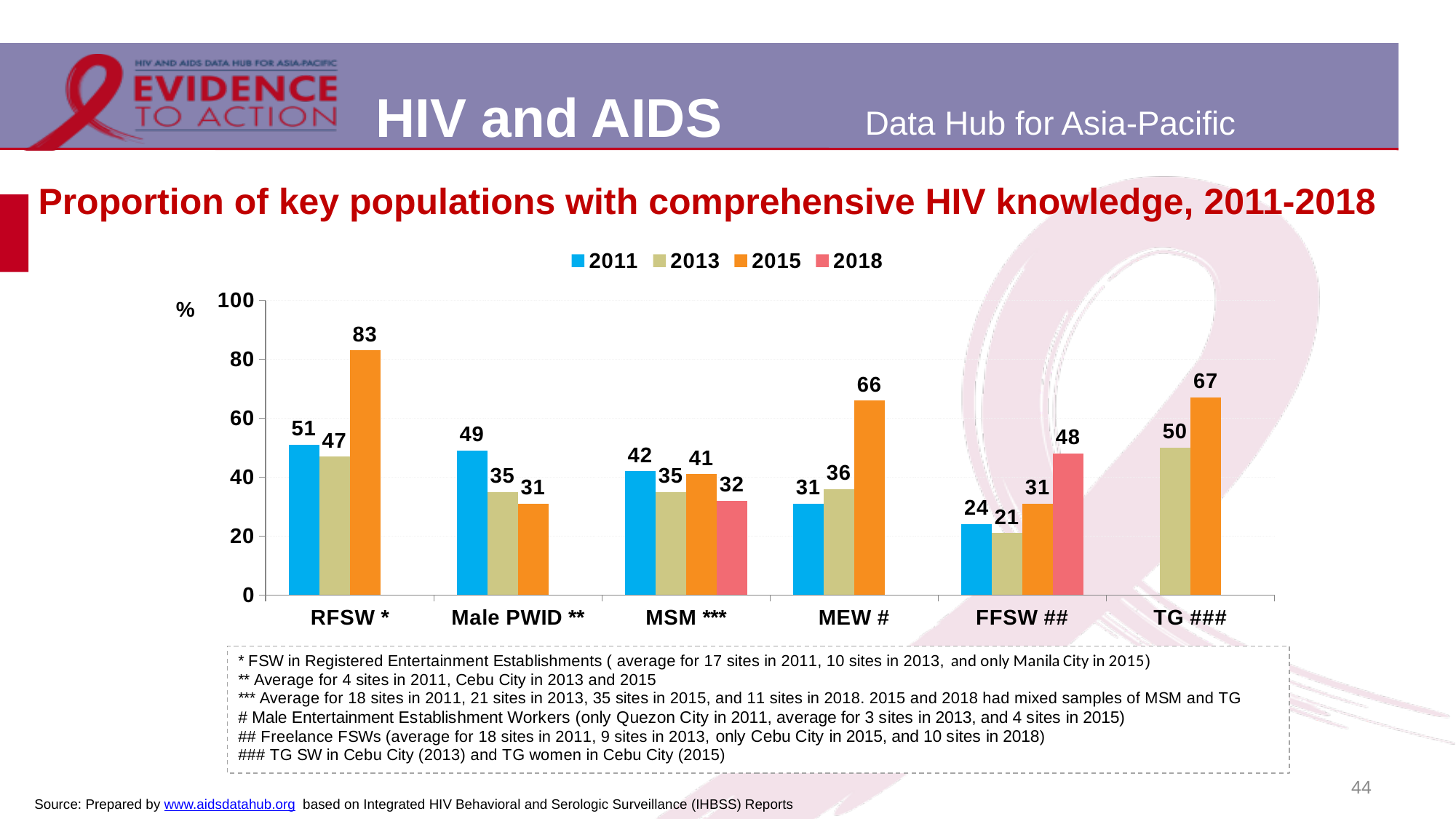
What is the value for FFSW ## in 2018? 48 What kind of chart is shown on the slide? Bar chart Which category has the highest value in 2015? RFSW * What is the difference between the 2015 and 2011 values for MEW #? 35 How many series does the legend list? 4 What is the value for MSM *** in 2018? 32 How many categories are shown on the x axis? 6 What is the value for RFSW * in 2015? 83 Which category has the lowest value in 2013? FFSW ## Which is larger for TG ###: the 2013 value or the 2015 value? 2015 Which year does the orange series represent in the legend? 2015 What is the value for Male PWID ** in 2011? 49